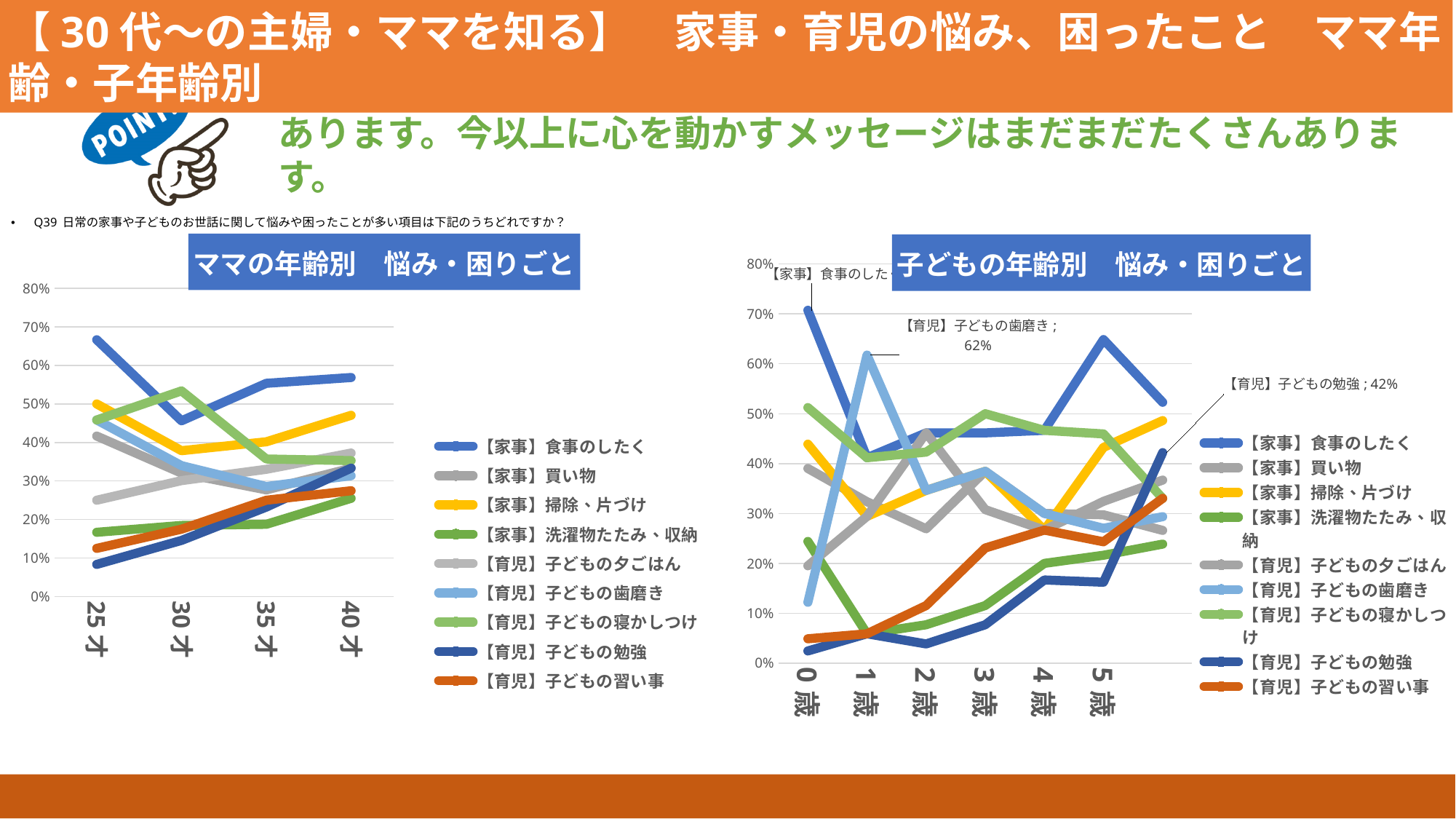
In the left chart (ママの年齢別 悩み・困りごと), which series has the highest value at 25才? 【家事】食事のしたく In the left chart (ママの年齢別 悩み・困りごと), is the value for 【育児】子どもの勉強 at 25才 greater or less than 10%? less In the right chart (子どもの年齢別 悩み・困りごと), what value is shown in the data label for 【育児】子どもの勉強? 42% What kind of chart is the left chart titled ママの年齢別 悩み・困りごと? line chart In the left chart (ママの年齢別 悩み・困りごと), does the value for 【育児】子どもの勉強 rise or fall from 25才 to 40才? rise How many age categories are shown on the x axis of the left chart (ママの年齢別 悩み・困りごと)? 4 In the right chart (子どもの年齢別 悩み・困りごと), at 1歳, which is larger: 【育児】子どもの歯磨き or 【家事】食事のしたく? 【育児】子どもの歯磨き In the right chart (子どもの年齢別 悩み・困りごと), what is the value for 【育児】子どもの歯磨き at 1歳? 62% What is the title of the right chart? 子どもの年齢別 悩み・困りごと How many series does the legend of the right chart (子どもの年齢別 悩み・困りごと) list? 9 In the left chart (ママの年齢別 悩み・困りごと), is the value for 【家事】食事のしたく at 25才 greater or less than 60%? greater In the right chart (子どもの年齢別 悩み・困りごと), is the value for 【育児】子どもの勉強 at 0歳 greater or less than 10%? less